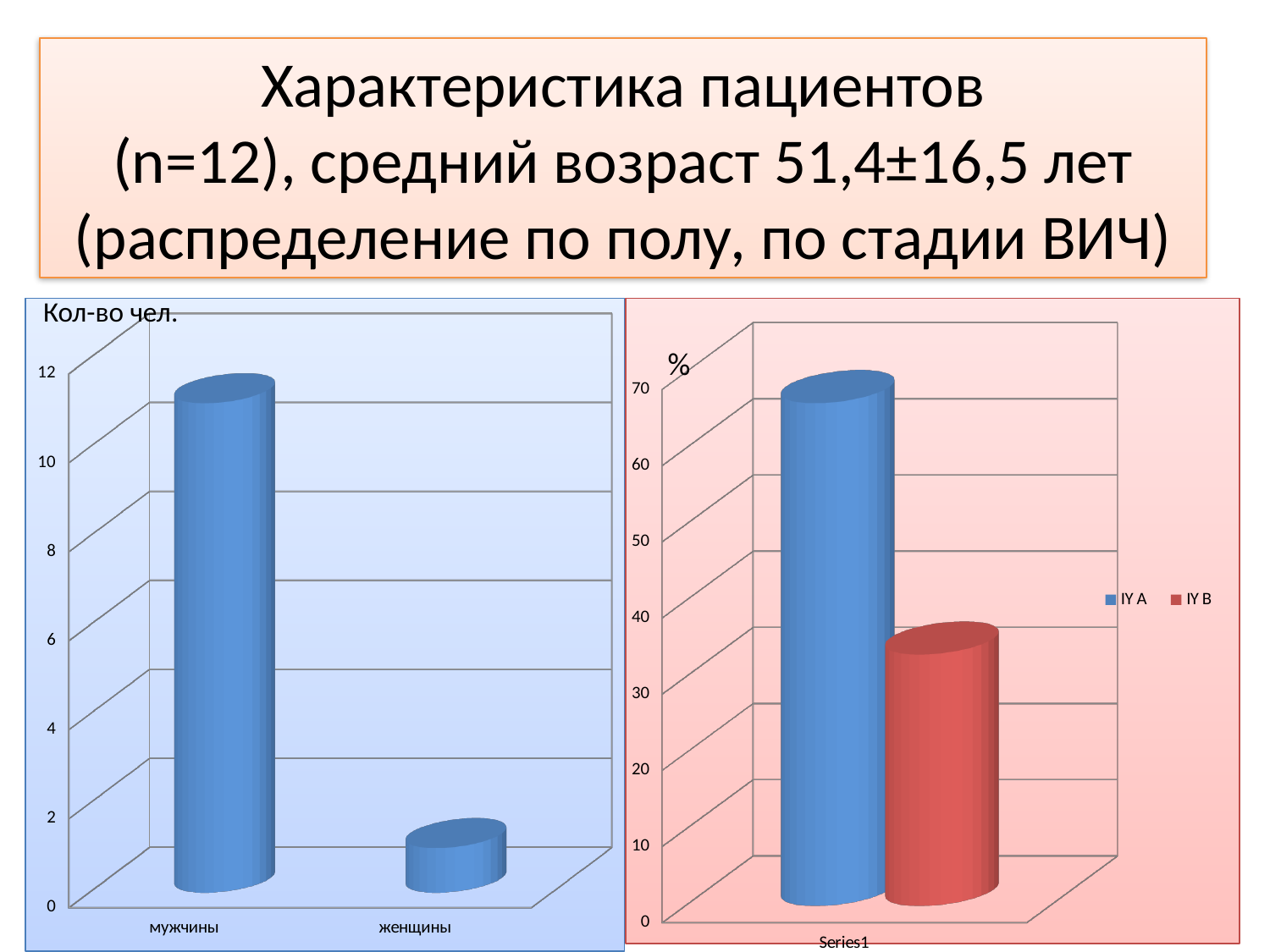
In the right chart (%), which series has the larger value, IY A or IY B? IY A In the right chart (%), is the value for IY A greater or less than 60? greater In the left chart (Кол-во чел.), is the value for женщины greater or less than 2? less In the right chart (%), is the value for IY B greater or less than 40? less In the left chart (Кол-во чел.), which category has the highest value? мужчины What kind of chart is the left chart (Кол-во чел.)? bar chart What kind of chart is the right chart (%)? bar chart In the right chart (%), how many series does the legend list? 2 In the left chart (Кол-во чел.), how many categories are shown on the x axis? 2 What are the two legend entries in the right chart (%)? IY A and IY B In the left chart (Кол-во чел.), which category has the lowest value? женщины